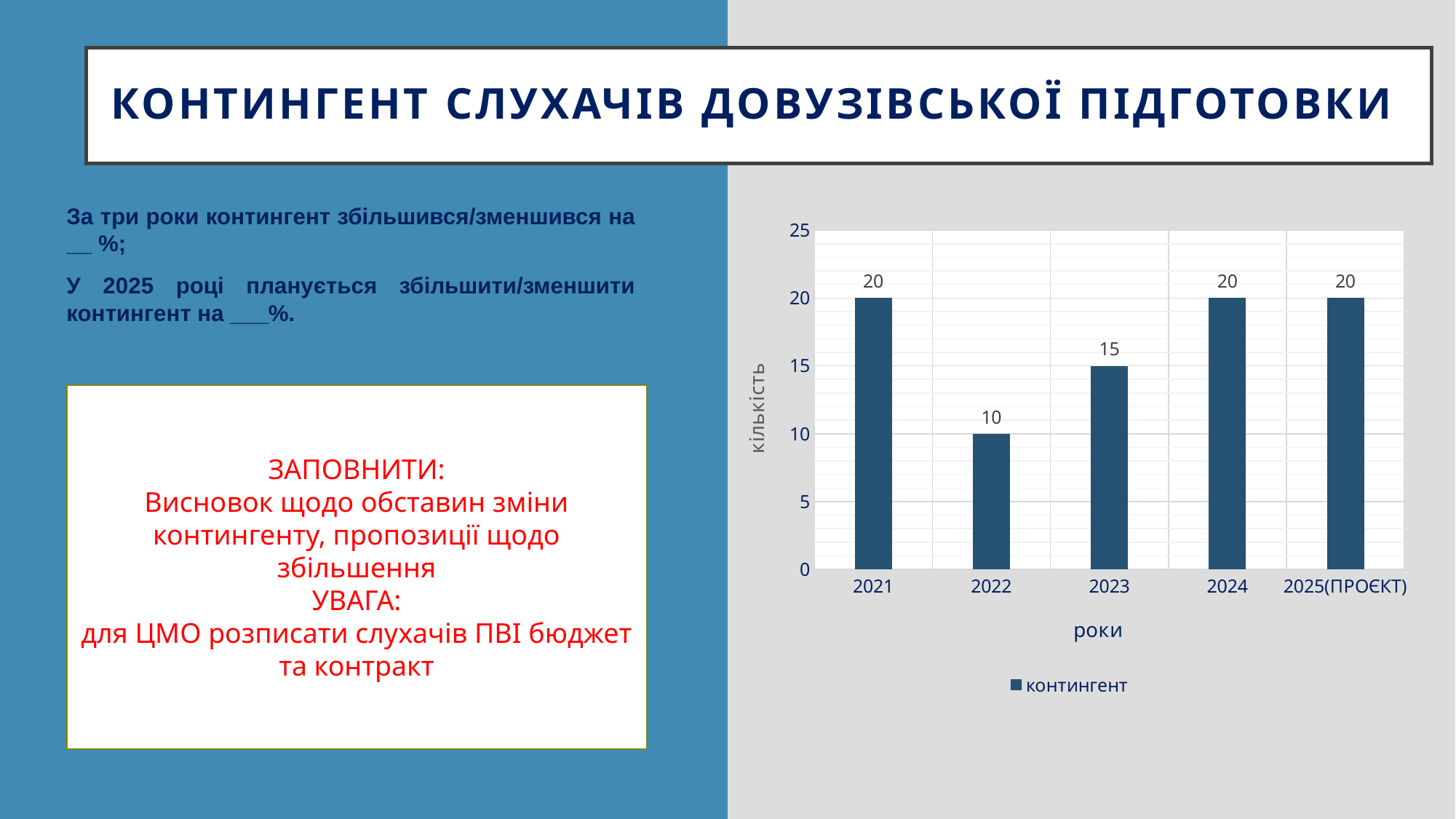
What is the value for 2025(ПРОЄКТ)? 20 What kind of chart is shown? bar chart What is the value for 2022? 10 What is the label of the y axis? кількість What is the difference between the values for 2024 and 2023? 5 Which is larger, the value for 2023 or the value for 2022? 2023 How many series does the legend list? 1 How many categories are shown on the x axis? 5 Which year has the lowest value? 2022 What is the difference between the values for 2021 and 2022? 10 What is the value for 2023? 15 What is the value for 2021? 20